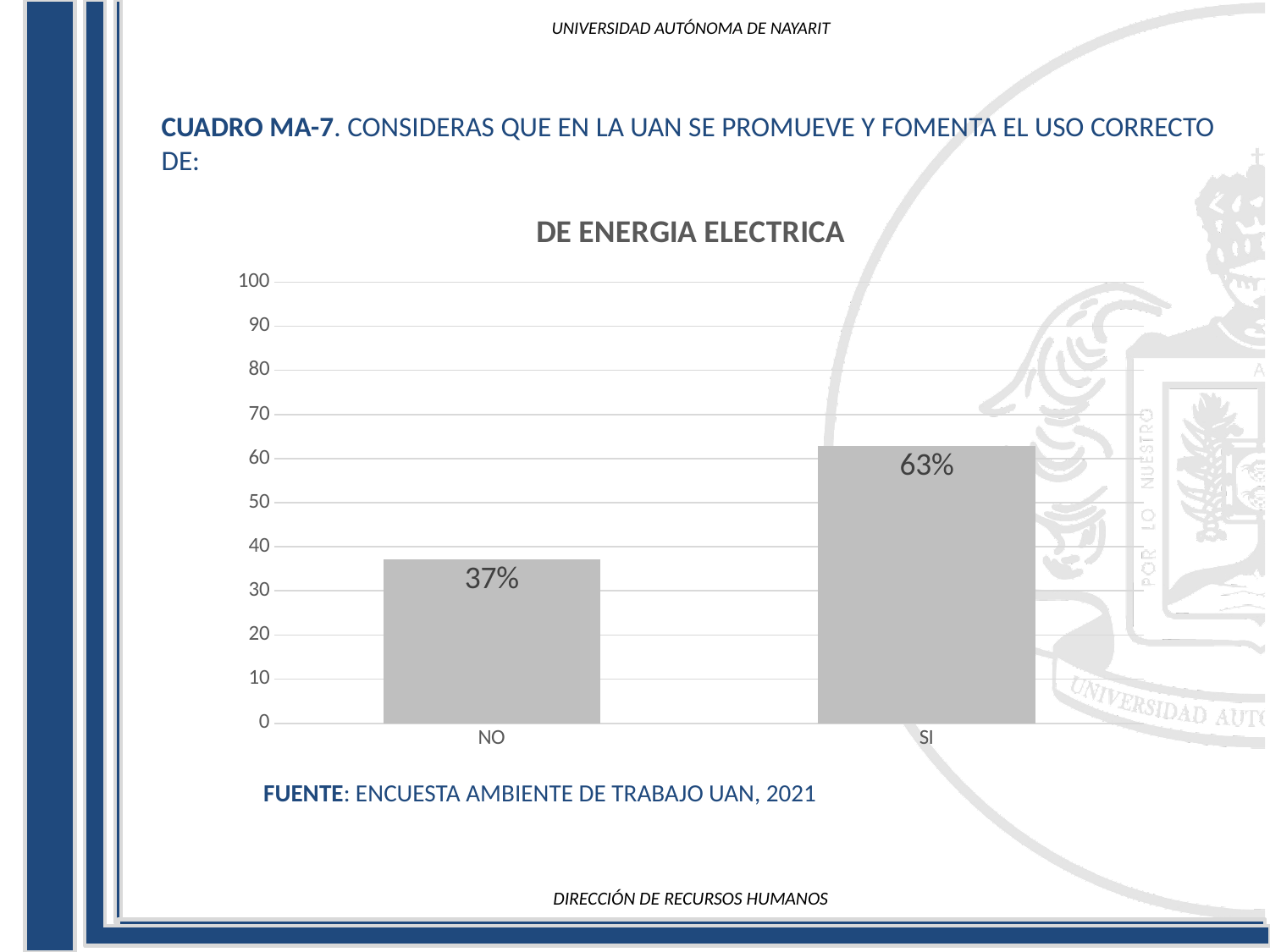
What is the value for NO? 37% What is the difference between the values for SI and NO? 26% Is the value for SI greater or less than 60? greater Which is larger, the value for NO or the value for SI? SI What kind of chart is shown on the slide? bar chart What is the title of the chart? DE ENERGIA ELECTRICA Which category has the lowest value? NO What is the highest value shown on the y axis? 100 Is the value for NO greater or less than 40? less What is the value for SI? 63% How many categories are shown on the x axis? 2 Which category has the highest value? SI